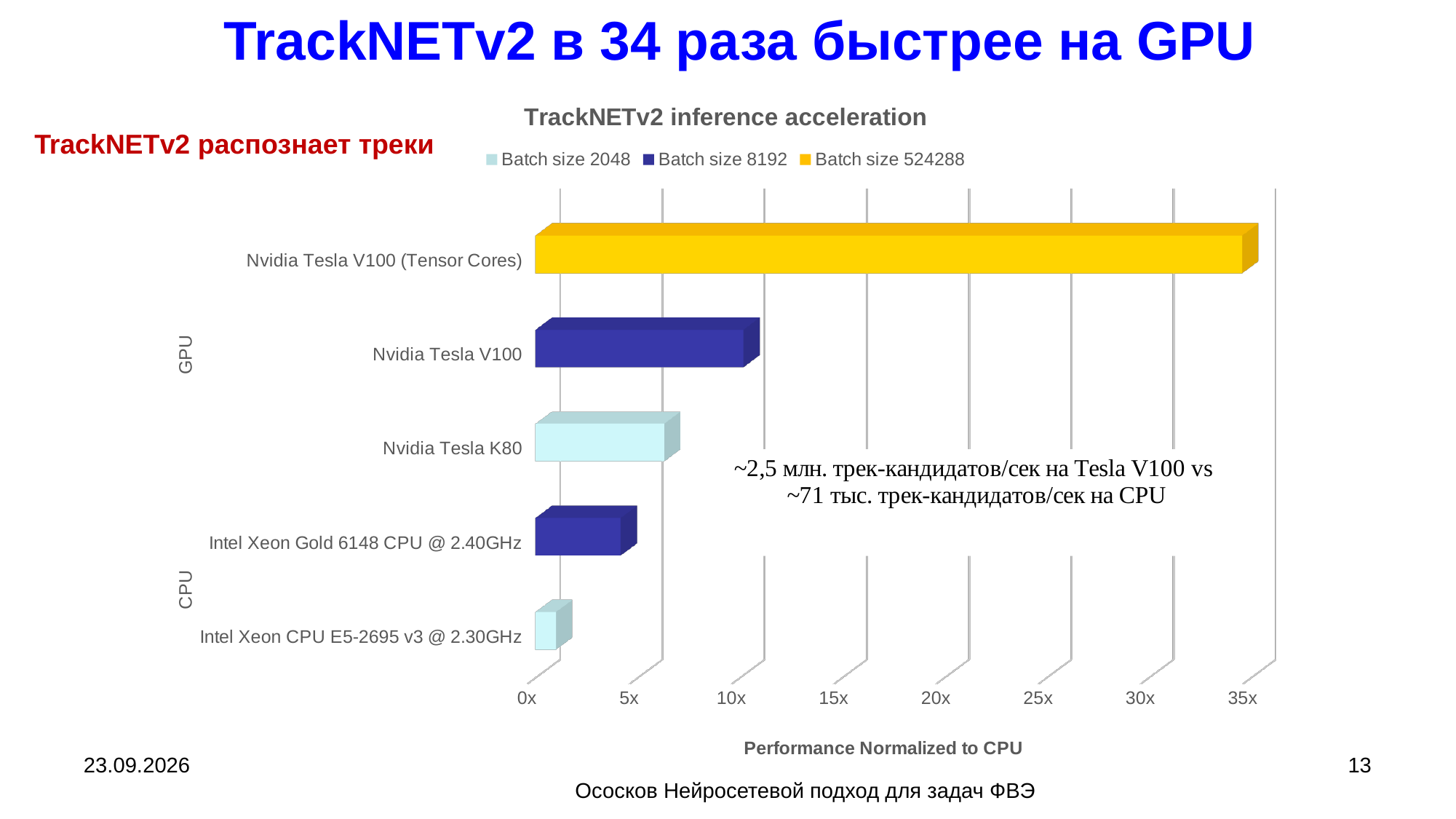
Is the value for Intel Xeon Gold 6148 CPU @ 2.40GHz greater or less than 10x? less Which has the larger value, Nvidia Tesla V100 or Nvidia Tesla K80? Nvidia Tesla V100 Is the value for Nvidia Tesla K80 greater or less than 5x? greater What kind of chart is shown on the slide? Bar chart What is the title of the chart? TrackNETv2 inference acceleration Which hardware category has the highest performance value in the chart? Nvidia Tesla V100 (Tensor Cores) What is the label of the horizontal axis of the chart? Performance Normalized to CPU Is the value for Nvidia Tesla V100 greater or less than 15x? less How many hardware categories are plotted in the chart? 5 How many series does the chart legend list? 3 Which hardware category has the lowest performance value in the chart? Intel Xeon CPU E5-2695 v3 @ 2.30GHz